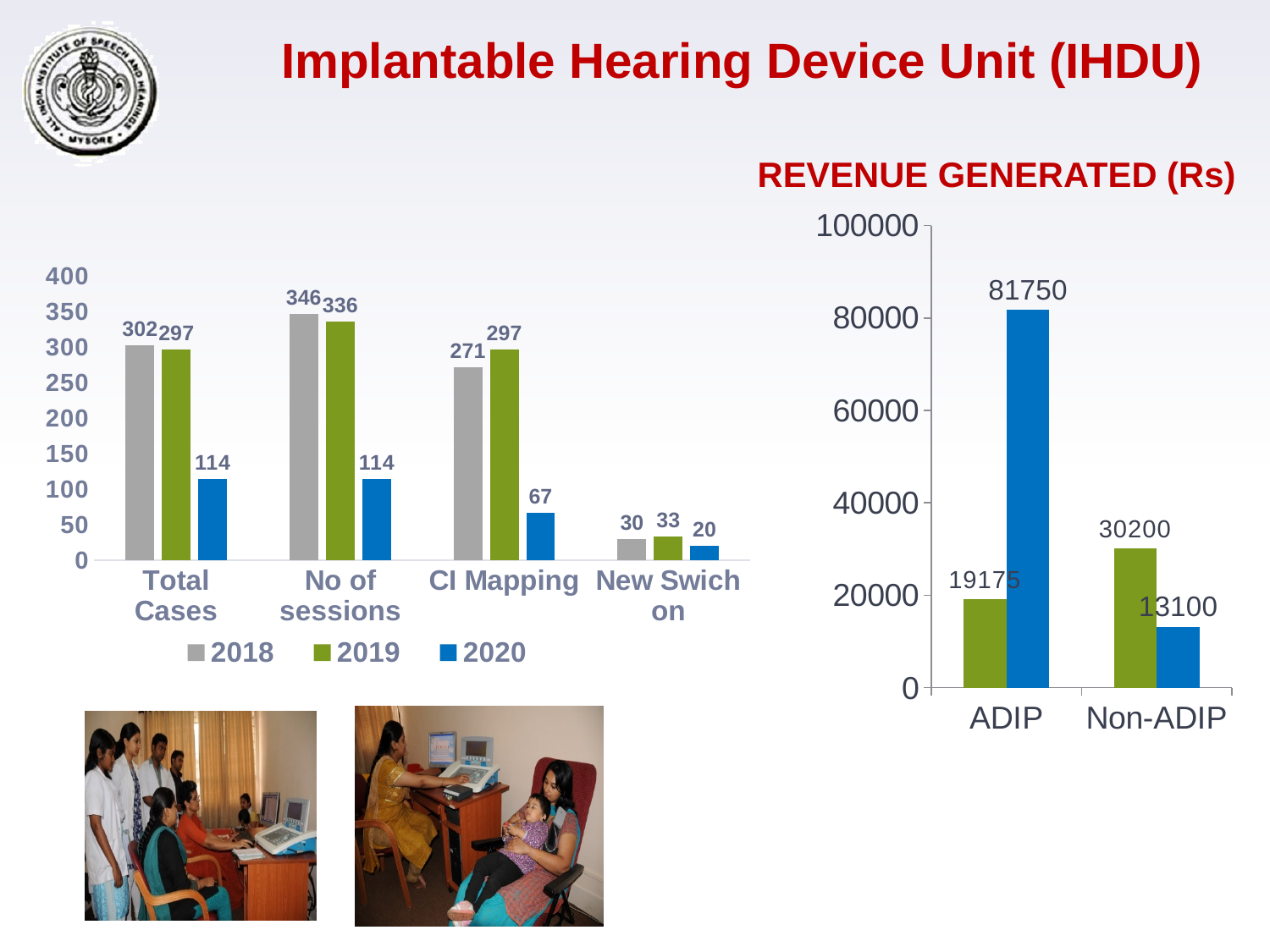
How many series does the legend of the left chart list? 3 In the left chart, which category has the lowest value for 2020? New Swich on What kind of chart is the REVENUE GENERATED (Rs) chart? Bar chart In the REVENUE GENERATED (Rs) chart, what is the difference between the green bar for Non-ADIP and the green bar for ADIP? 11025 In the left chart, what is the difference between the 2019 and 2020 values for CI Mapping? 230 In the left chart, which is larger for CI Mapping: the 2018 value or the 2019 value? 2019 In the left chart, what is the value for CI Mapping in 2020? 67 In the left chart, which category has the highest value for 2018? No of sessions In the left chart, what is the value for No of sessions in 2019? 336 In the REVENUE GENERATED (Rs) chart, what is the value of the blue bar for ADIP? 81750 In the left chart, what is the value for Total Cases in 2018? 302 How many categories are shown on the x axis of the left chart? 4